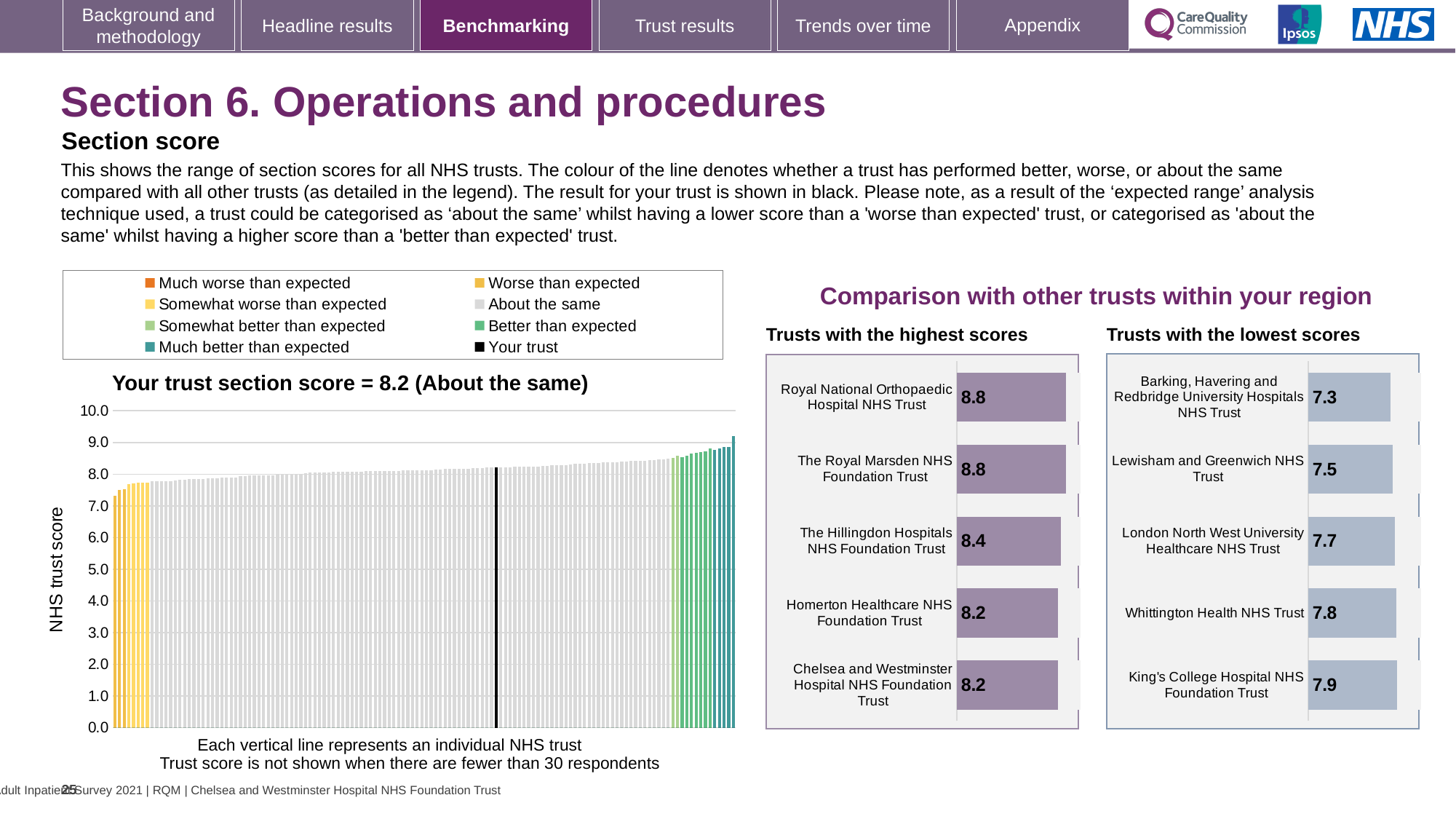
In the main chart of section scores for all NHS trusts, do the values rise or fall from left to right? rise In the 'Trusts with the highest scores' chart, which has the larger score: The Royal Marsden NHS Foundation Trust or The Hillingdon Hospitals NHS Foundation Trust? The Royal Marsden NHS Foundation Trust In the main chart of section scores for all NHS trusts, is the value of the lowest-scoring trust greater or less than 8.0? less In the 'Trusts with the lowest scores' chart, which trust has the lowest score? Barking, Havering and Redbridge University Hospitals NHS Trust How many entries does the legend above the main chart list? 8 How many trusts are listed in the 'Trusts with the lowest scores' chart? 5 In the main chart titled 'Your trust section score = 8.2 (About the same)', what is the section score for your trust? 8.2 In the 'Trusts with the highest scores' chart, what is the difference between the scores of The Hillingdon Hospitals NHS Foundation Trust and Homerton Healthcare NHS Foundation Trust? 0.2 In the 'Trusts with the lowest scores' chart, which trust has the highest score? King's College Hospital NHS Foundation Trust In the 'Trusts with the lowest scores' chart, what is the score for Lewisham and Greenwich NHS Trust? 7.5 In the 'Trusts with the highest scores' chart, what is the score for The Hillingdon Hospitals NHS Foundation Trust? 8.4 In the 'Trusts with the lowest scores' chart, what is the difference between the scores of King's College Hospital NHS Foundation Trust and Barking, Havering and Redbridge University Hospitals NHS Trust? 0.6